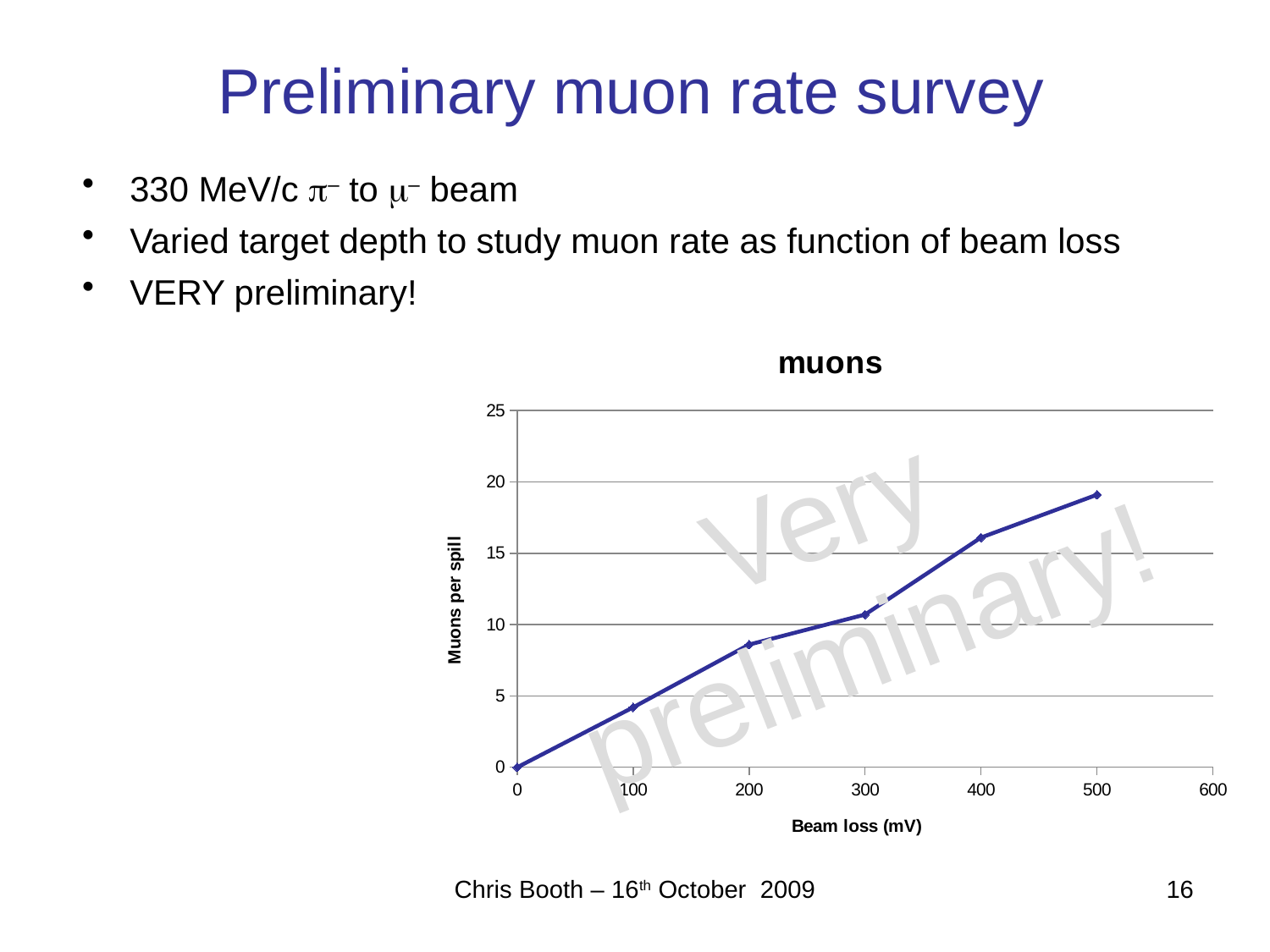
Do the muons per spill values rise or fall as beam loss increases? rise Is the value of muons per spill at a beam loss of 400 mV greater or less than 15? greater Is the value of muons per spill at a beam loss of 500 mV greater or less than 20? less What type of chart is shown on the slide? line chart What is the title of the chart? muons What is the value of muons per spill at a beam loss of 0 mV? 0 Is the value of muons per spill at a beam loss of 200 mV greater or less than 10? less What is the label of the x axis of the chart? Beam loss (mV) Which has a higher muons per spill value: a beam loss of 200 mV or 400 mV? 400 mV At which beam loss value is the muons per spill highest? 500 How many data points are plotted on the chart? 6